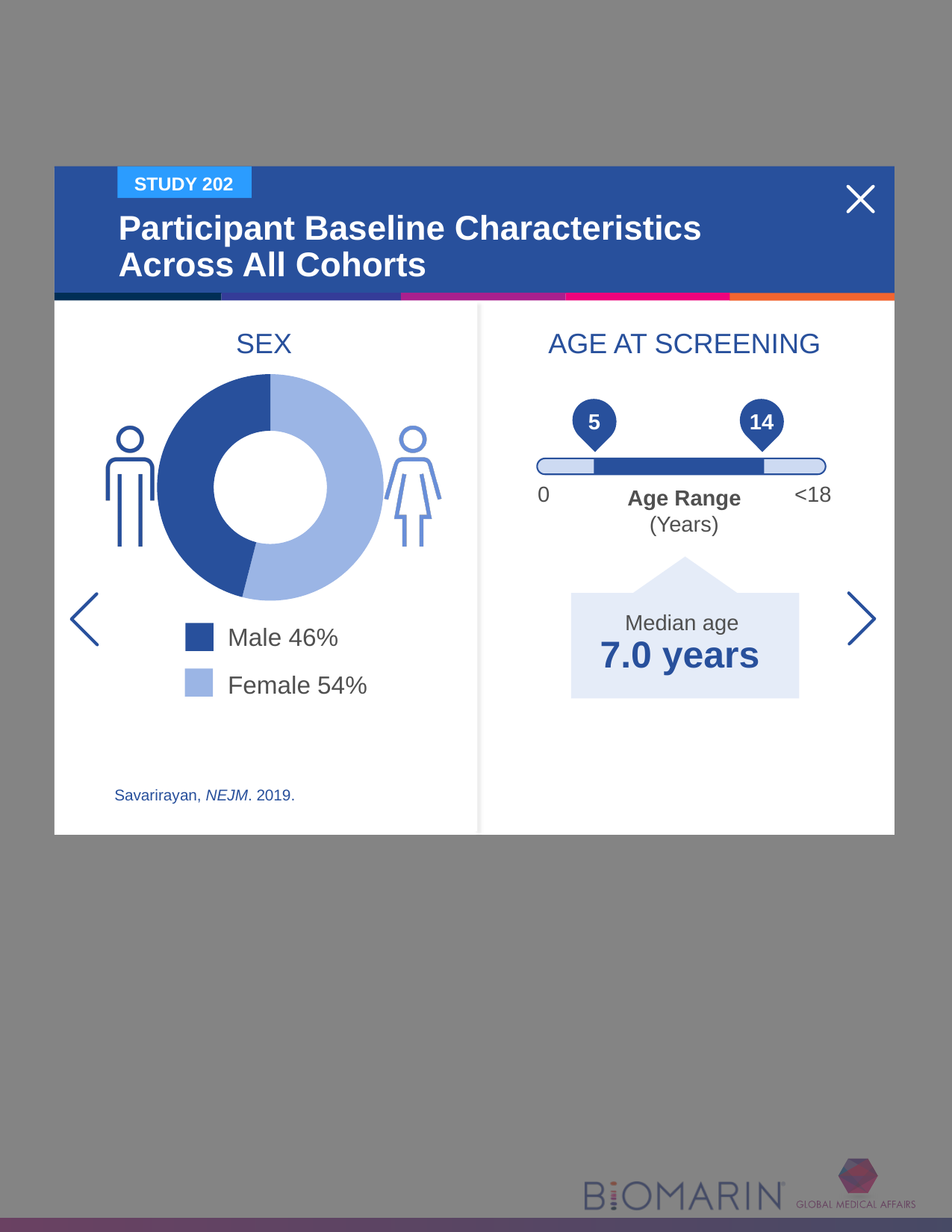
In the AGE AT SCREENING chart, what is the lower end of the age range shown on the bar? 5 In the SEX chart, which colour represents Male? Dark blue In the AGE AT SCREENING chart, what is the median age? 7.0 years In the AGE AT SCREENING chart, what is the upper end of the age range shown on the bar? 14 In the SEX chart, how many categories are shown? 2 In the SEX chart, what is the difference in percentage points between Female and Male? 8 What kind of chart is the SEX chart? Pie chart (donut) In the SEX chart, what percentage of participants are female? 54% In the SEX chart, which category has the larger share, Male or Female? Female In the SEX chart, what percentage of participants are male? 46% In the SEX chart, which category has the smallest share? Male In the SEX chart, what share of the pie does the Female slice represent? 54%